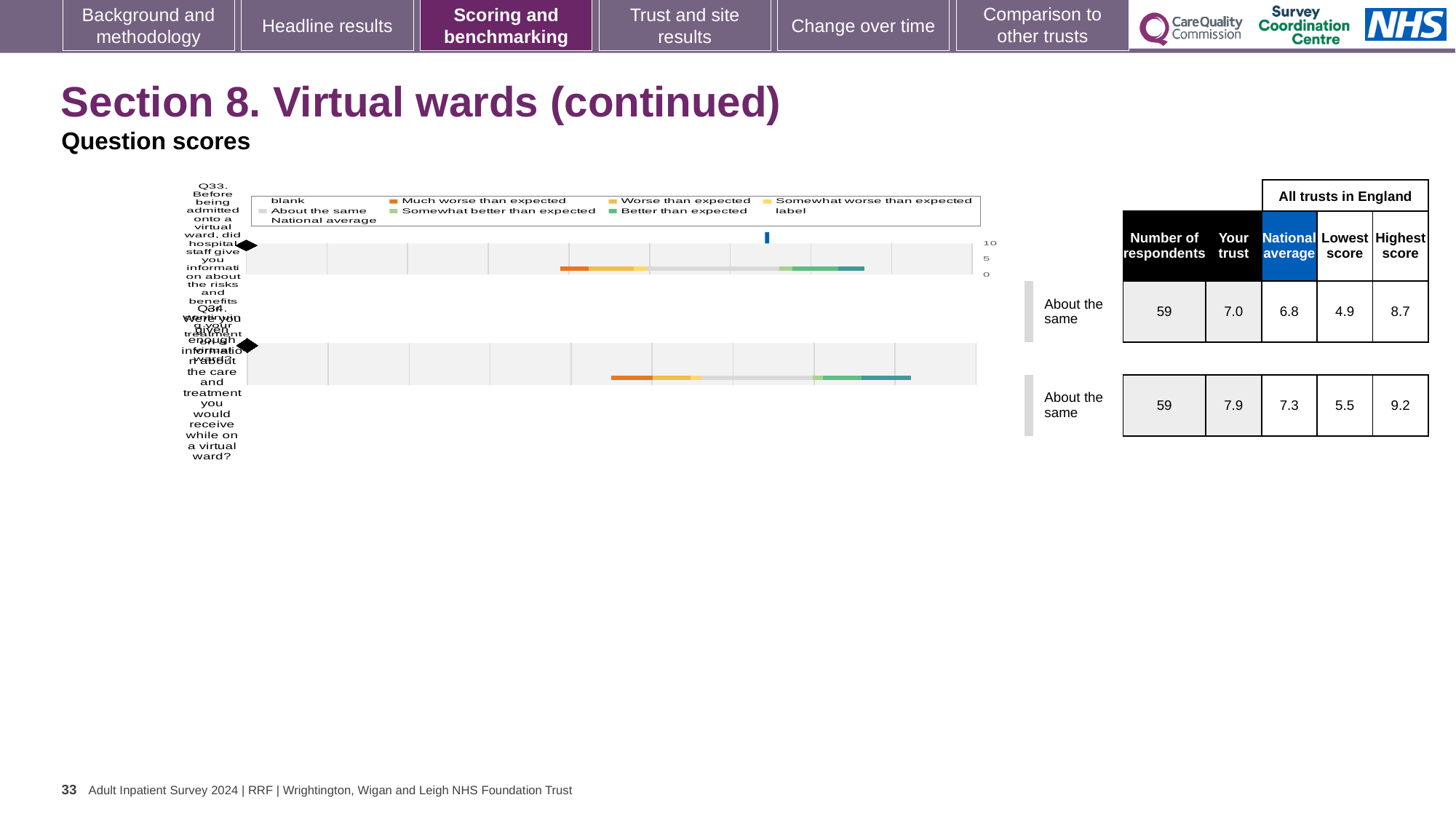
What kind of chart is used to show the question scores for Q33 and Q34? bar chart What is the national average score for Q34 (enough information about care and treatment on a virtual ward)? 7.3 For Q33, which is larger: the 'Your trust' score or the national average? Your trust (7.0) What is the difference between the highest and lowest scores for Q33? 3.8 How many respondents answered Q33? 59 What is the highest score among all trusts in England for Q34? 9.2 For Q34, how much higher is the 'Your trust' score than the national average? 0.6 How many questions (bars) are plotted on the chart? 2 Which question has the higher 'Your trust' score, Q33 or Q34? Q34 What is the lowest score among all trusts in England for Q33? 4.9 What is the 'Your trust' score for Q33 (information about the risks and benefits of a virtual ward)? 7.0 What benchmark category is shown for Q34? About the same